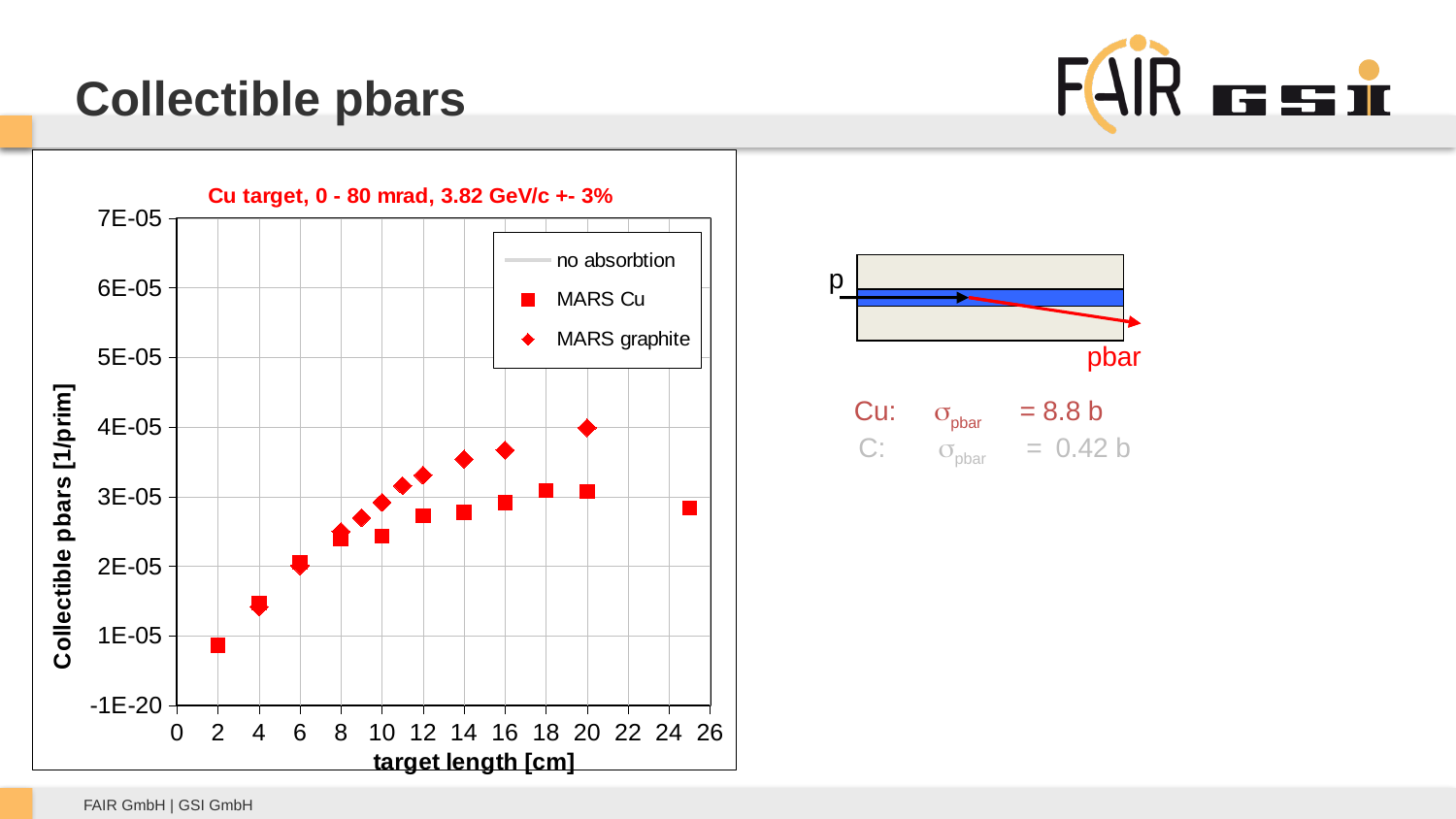
Is the MARS graphite value at a target length of 16 cm greater or less than 3E-05? greater What is the label of the x axis? target length [cm] What kind of chart is shown on the slide? scatter chart Is the MARS Cu value at a target length of 4 cm greater or less than 1E-05? greater Is the MARS Cu value at a target length of 25 cm greater or less than 3E-05? less At which target length does the MARS graphite series reach its highest value? 20 cm At which target length does the MARS Cu series have its lowest value? 2 cm What is the title of the chart? Cu target, 0 - 80 mrad, 3.82 GeV/c +- 3% At a target length of 16 cm, which series has the higher value, MARS Cu or MARS graphite? MARS graphite How many MARS Cu data points are plotted? 11 How many series does the legend list? 3